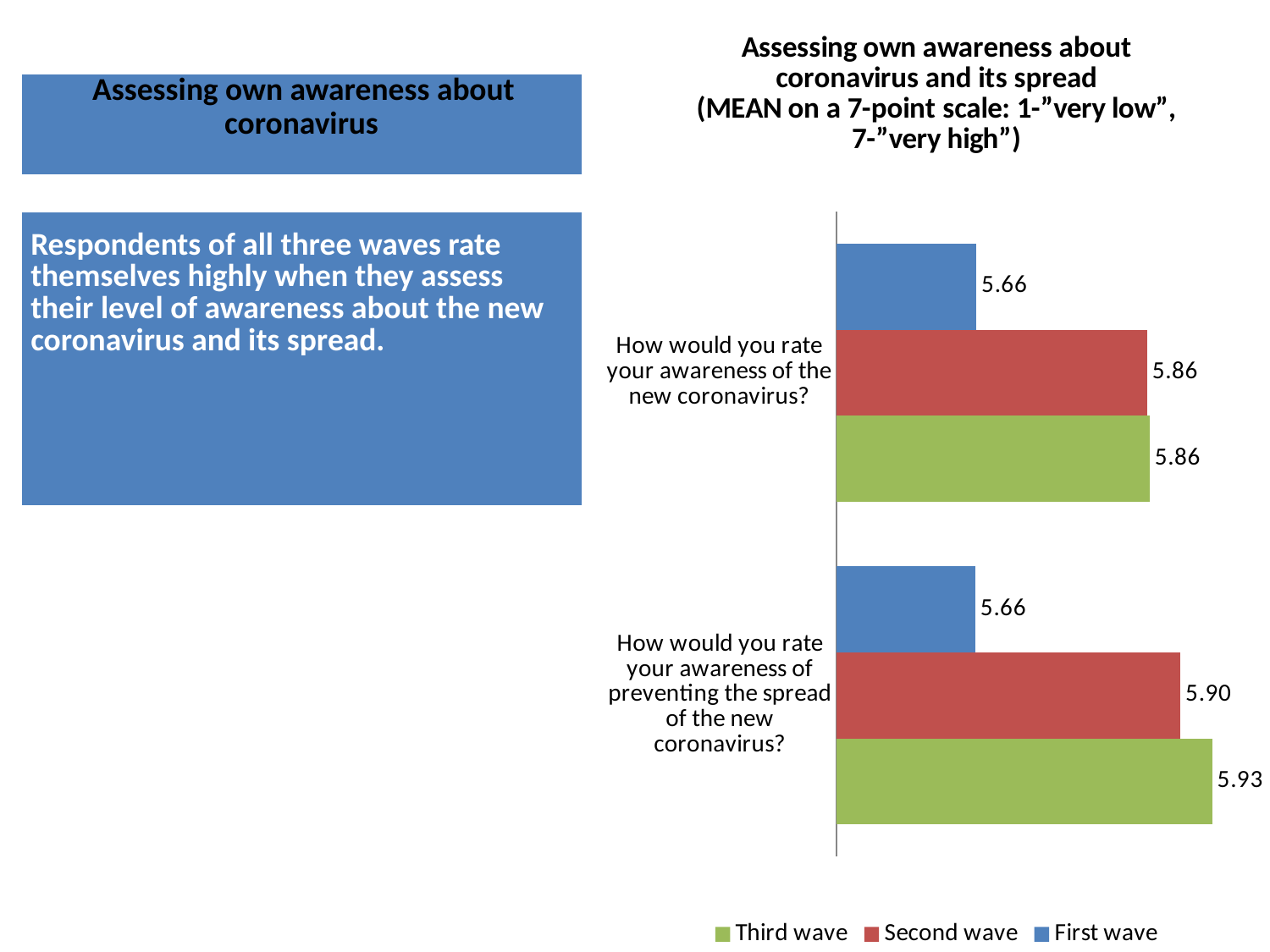
What is the difference between the Third wave and First wave values for "How would you rate your awareness of preventing the spread of the new coronavirus?"? 0.27 What is the Second wave value for "How would you rate your awareness of the new coronavirus?"? 5.86 What is the First wave value for "How would you rate your awareness of the new coronavirus?"? 5.66 Which colour represents the Second wave in the chart legend? red Which wave has the lowest value for "How would you rate your awareness of the new coronavirus?"? First wave How many question categories are plotted on the chart? 2 What is the Third wave value for "How would you rate your awareness of preventing the spread of the new coronavirus?"? 5.93 What kind of chart is shown on the slide? bar chart Which wave has the highest value for "How would you rate your awareness of preventing the spread of the new coronavirus?"? Third wave How many series does the chart legend list? 3 Which is larger: the Second wave value for awareness of the new coronavirus or the Second wave value for awareness of preventing its spread? awareness of preventing the spread (5.90) What is the Second wave value for "How would you rate your awareness of preventing the spread of the new coronavirus?"? 5.90